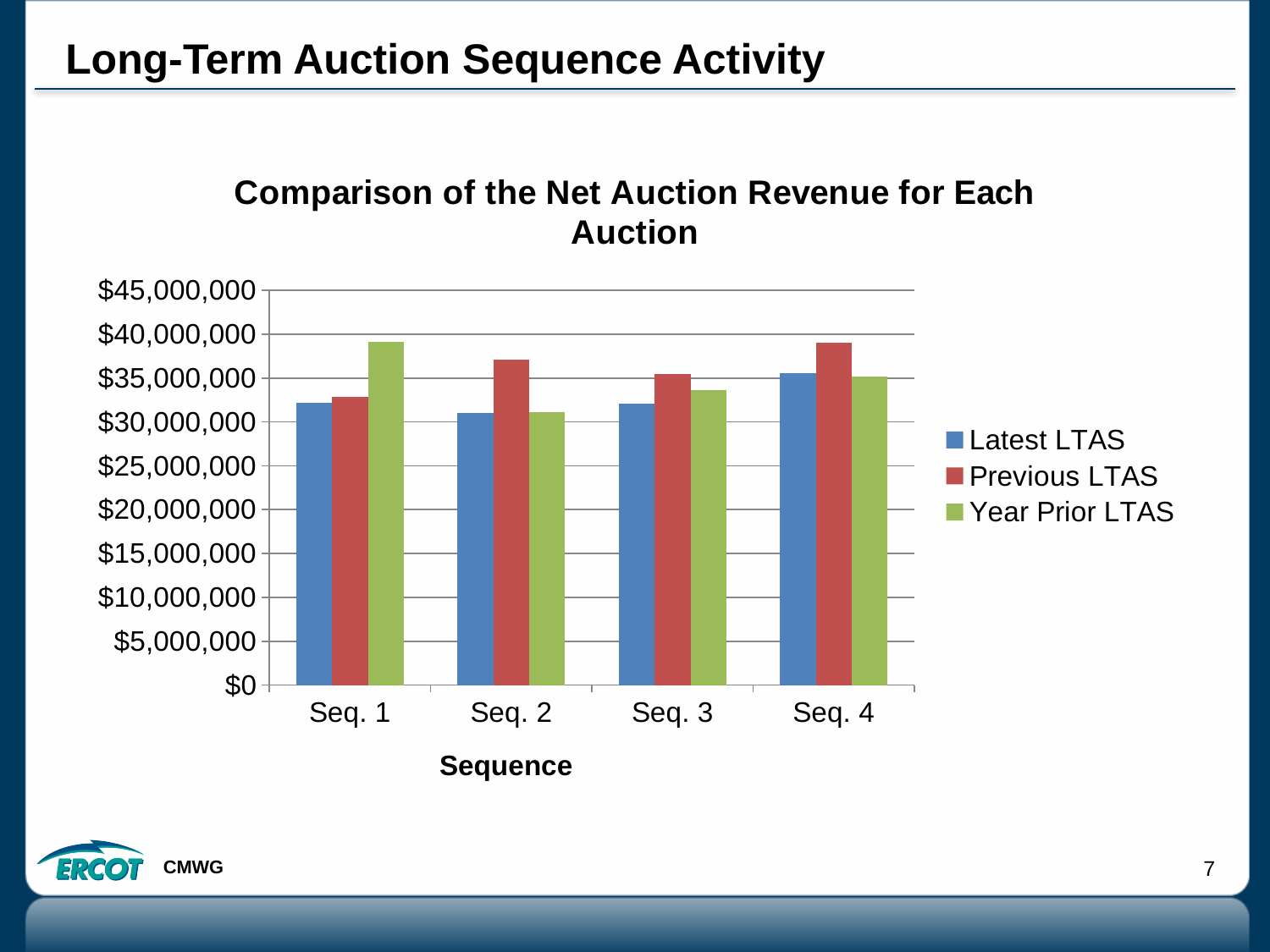
What is the title of the chart? Comparison of the Net Auction Revenue for Each Auction Is the Previous LTAS value for Seq. 4 greater or less than $35,000,000? greater Which series is shown in green in the chart? Year Prior LTAS Which sequence has the highest Year Prior LTAS value? Seq. 1 What kind of chart is shown on the slide? Bar chart Is the Latest LTAS value for Seq. 2 greater or less than $35,000,000? less For Seq. 2, which is larger: Previous LTAS or Latest LTAS? Previous LTAS Is the Year Prior LTAS value for Seq. 1 greater or less than $35,000,000? greater How many sequences are shown on the x axis of the chart? 4 For Seq. 1, which is larger: Year Prior LTAS or Latest LTAS? Year Prior LTAS How many series does the chart's legend list? 3 Which sequence has the highest Latest LTAS value? Seq. 4